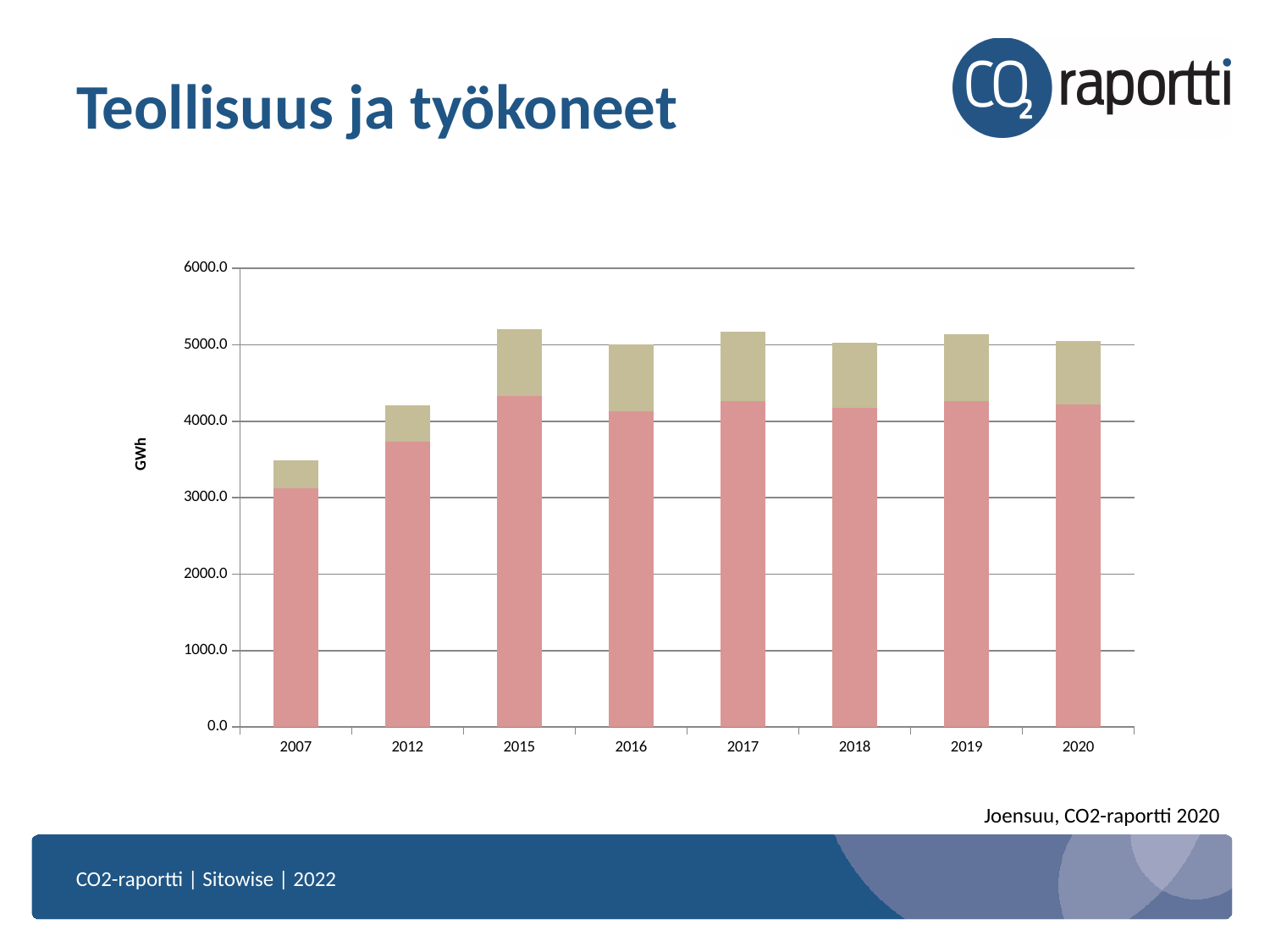
Is the total value for 2015 greater or less than 5000? greater Is the total value for 2012 greater or less than 4000? greater Which year has the lowest total bar in the chart? 2007 Which year has the larger total bar, 2007 or 2012? 2012 Which year has the larger total bar, 2012 or 2015? 2015 What kind of chart is shown on the slide? stacked bar chart Do the total bar values rise or fall from 2007 to 2015? rise Is the total value for 2007 greater or less than 4000? less What unit is shown on the y axis of the chart? GWh How many years are shown on the x axis of the chart? 8